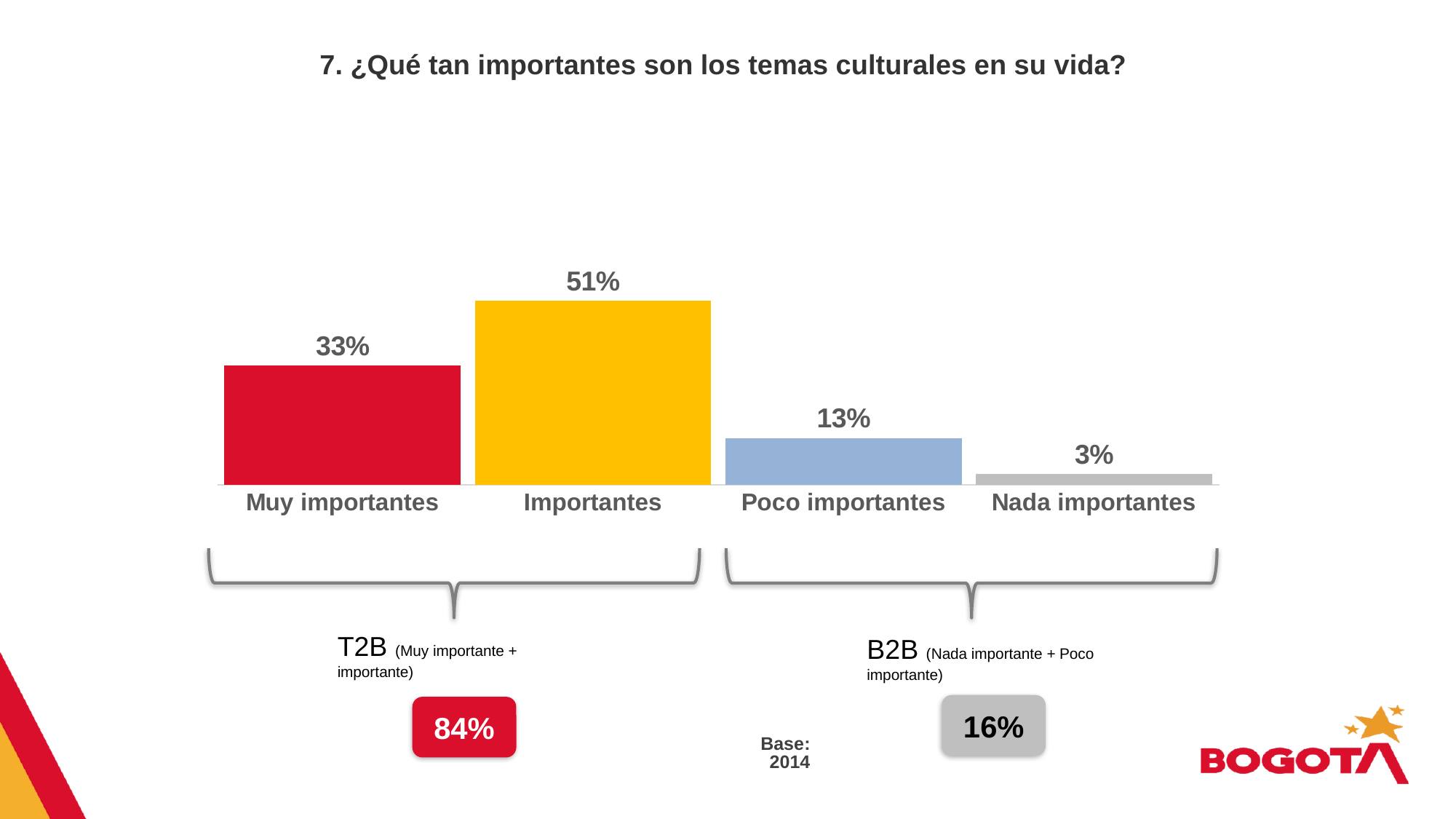
Which category has the lowest value? Nada importantes What is the value for Nada importantes? 3% How many categories are shown in the chart? 4 What kind of chart is shown on the slide? Bar chart What is the base year shown on the slide? 2014 What is the value for Importantes? 51% What is the difference between the values for Importantes and Muy importantes? 18% Which category has the highest value? Importantes What is the value for Poco importantes? 13% What is the value for Muy importantes? 33% Which is larger, the value for Poco importantes or the value for Nada importantes? Poco importantes What is the T2B value (Muy importante + importante) shown below the chart? 84%